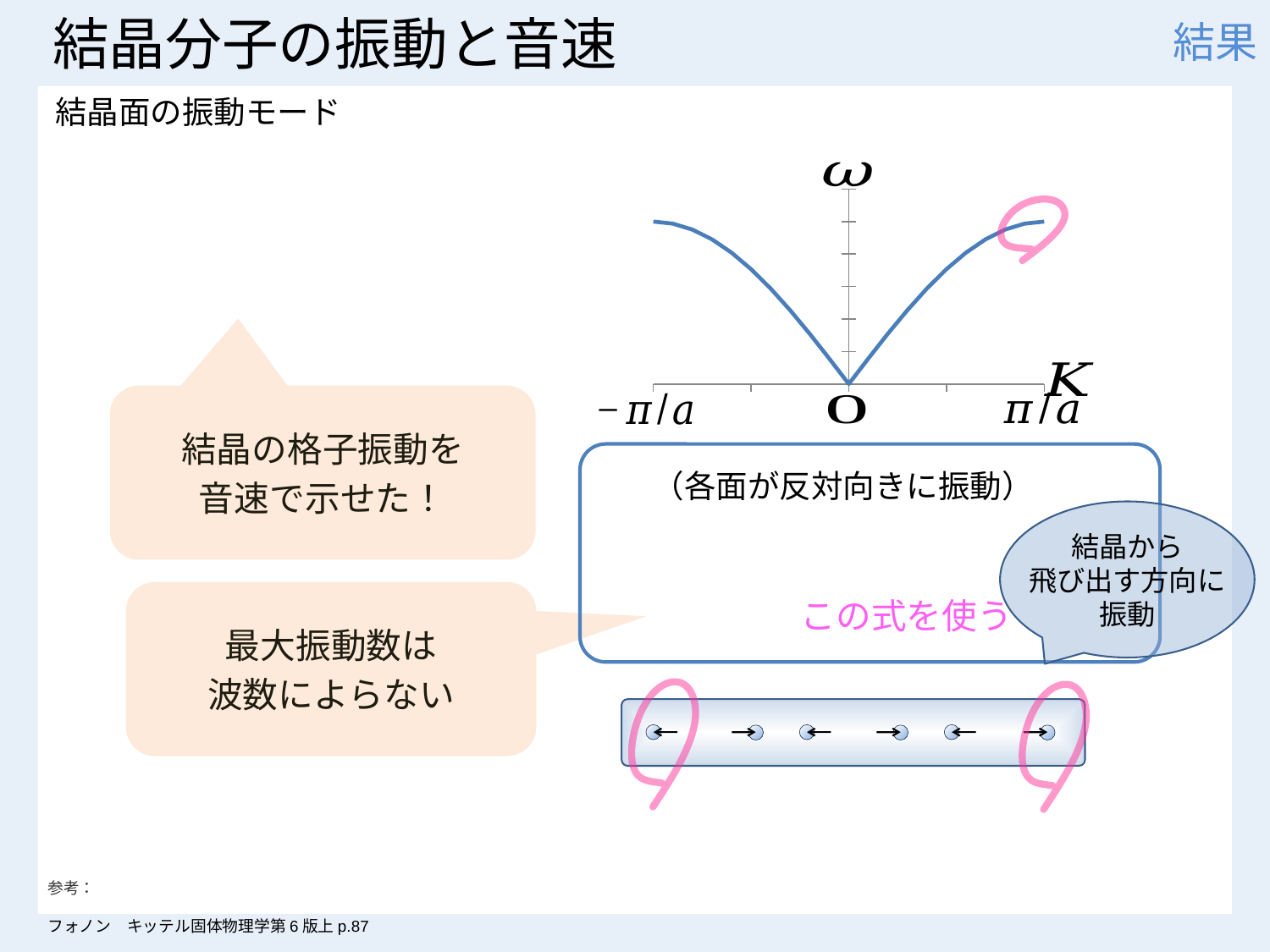
At which horizontal-axis label does the curve reach its lowest value? O What kind of chart is the ω versus K plot on the slide? line chart What label is written on the horizontal axis of the dispersion chart? K Which is larger on the dispersion chart: the value of ω at K = π/a or at K = O? π/a How many curves are plotted on the dispersion chart? 1 Does the curve rise or fall as K increases from O toward π/a? rise What are the two labelled end points of the horizontal axis on the dispersion chart? -π/a and π/a What label is written on the vertical axis of the dispersion chart? ω Does the curve rise or fall as K increases from -π/a toward O? fall